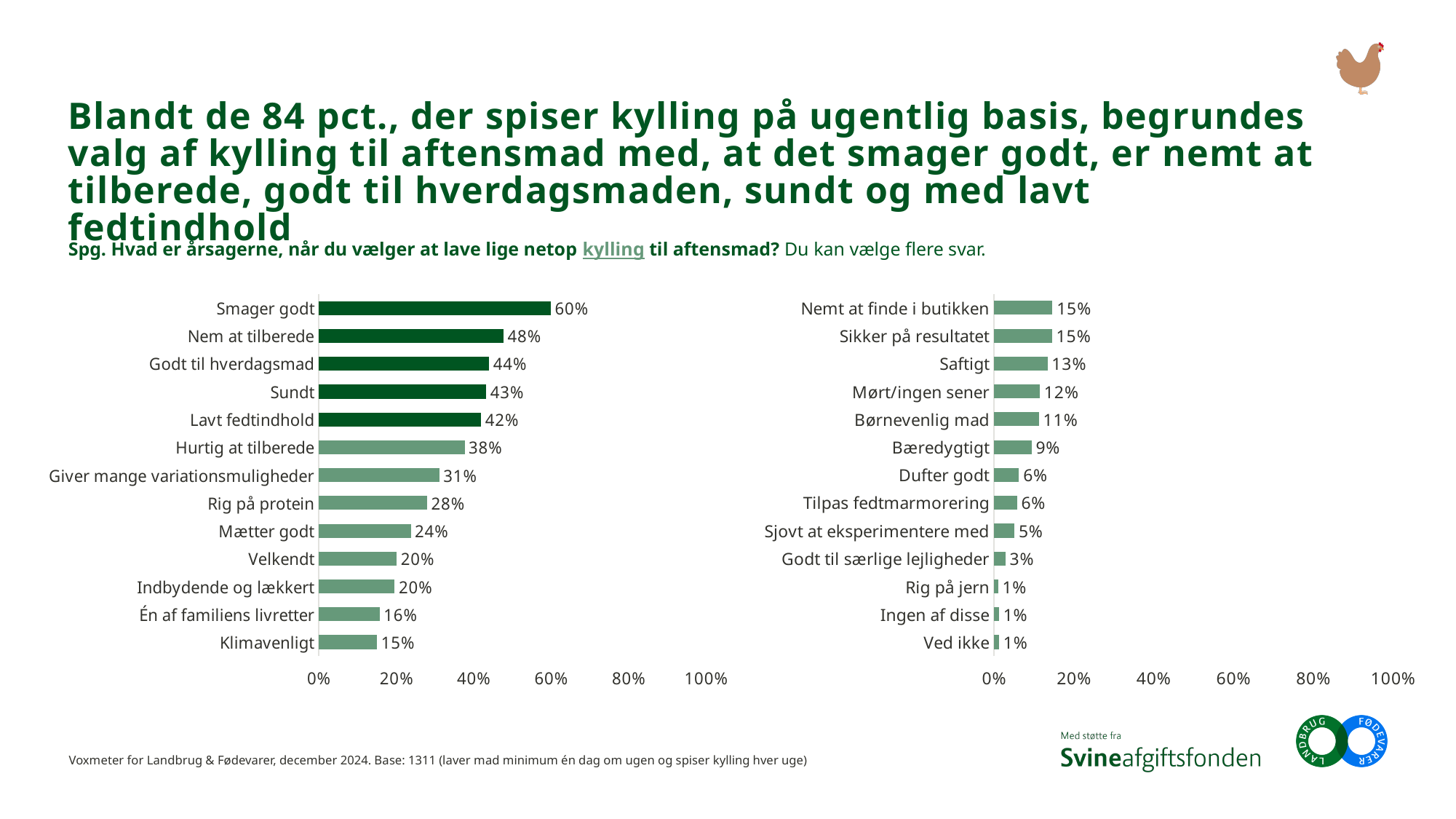
In the left chart, which category has the highest value? Smager godt In the left chart, what is the difference between Smager godt and Nem at tilberede? 12% How many categories are shown in the left chart? 13 In the right chart, which category has the highest value? Nemt at finde i butikken and Sikker på resultatet (both 15%) In the right chart, what is the value for Saftigt? 13% In the left chart, what is the value for Hurtig at tilberede? 38% What kind of chart is the right chart? Bar chart In the right chart, what is the value for Bæredygtigt? 9% In the left chart, which category has the lowest value? Klimavenligt In the right chart, what is the difference between Sikker på resultatet and Godt til særlige lejligheder? 12% In the left chart, what is the value for Smager godt? 60% In the right chart, which is larger, Mørt/ingen sener or Dufter godt? Mørt/ingen sener